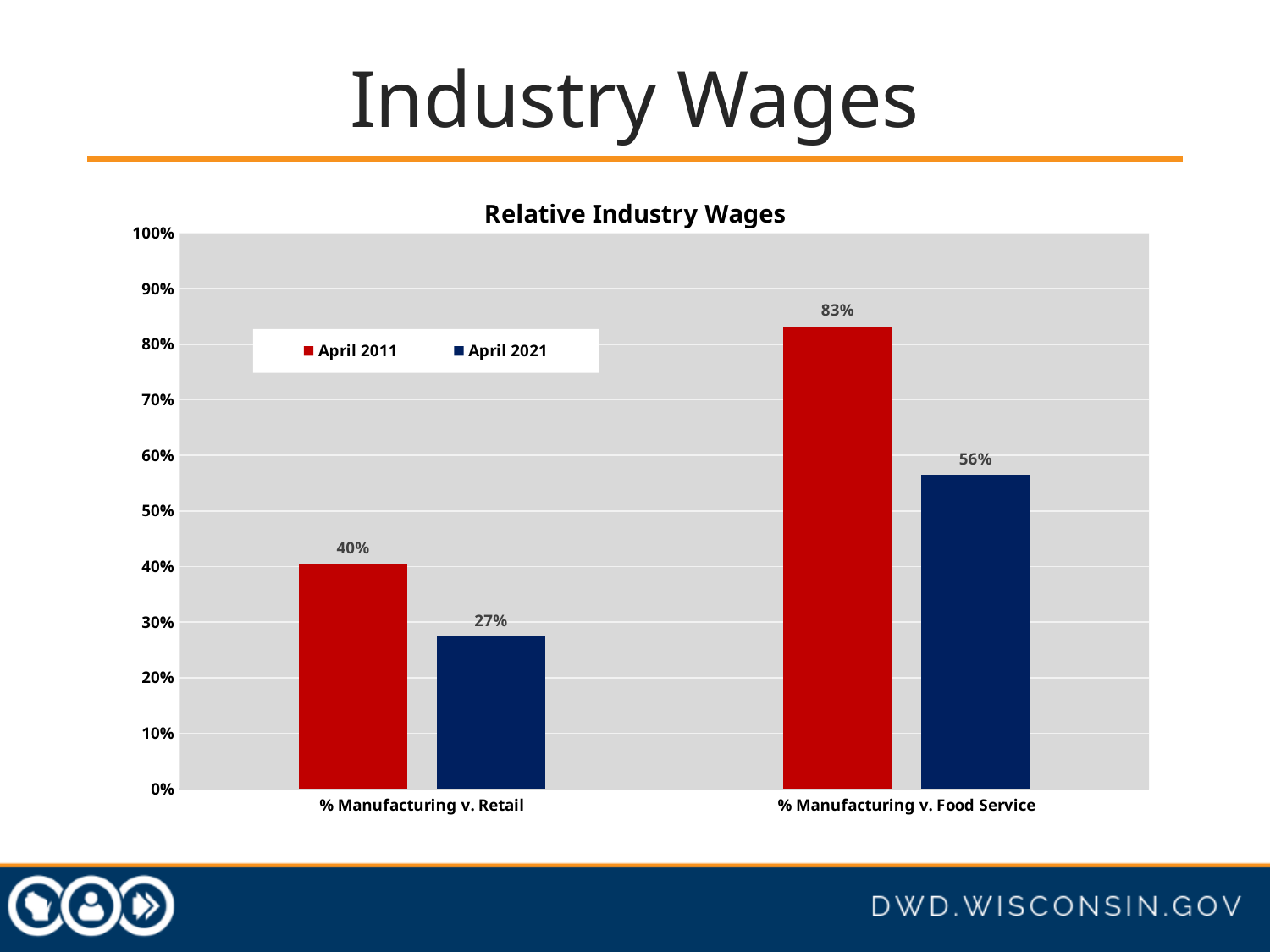
How many series does the legend list? 2 What is the title of the chart? Relative Industry Wages Which bar has the lowest value in the chart? April 2021, % Manufacturing v. Retail What is the April 2011 value for % Manufacturing v. Retail? 40% Which is larger: the April 2021 value for % Manufacturing v. Retail or the April 2021 value for % Manufacturing v. Food Service? % Manufacturing v. Food Service What is the difference between the April 2011 and April 2021 values for % Manufacturing v. Food Service? 27% What is the April 2021 value for % Manufacturing v. Retail? 27% What is the April 2021 value for % Manufacturing v. Food Service? 56% Which bar has the highest value in the chart? April 2011, % Manufacturing v. Food Service What is the difference between the April 2011 and April 2021 values for % Manufacturing v. Retail? 13% What kind of chart is shown on the slide? Bar chart What is the April 2011 value for % Manufacturing v. Food Service? 83%